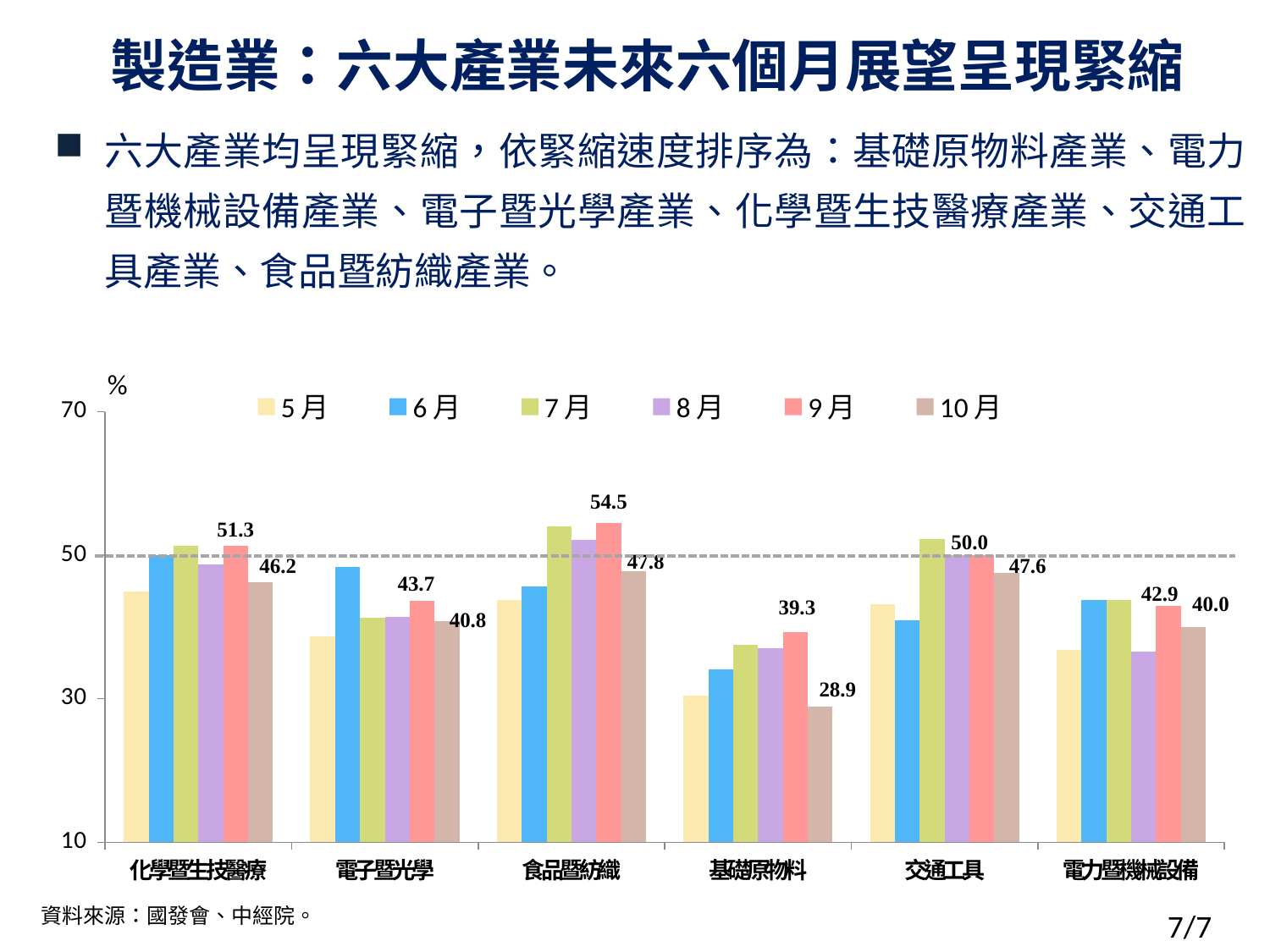
How many industry categories are shown on the x axis? 6 How many series does the legend list? 6 Which category has the lowest 9月 value? 基礎原物料 Is the 7月 value for 食品暨紡織 greater or less than 50? greater What is the value for 10月 in the 基礎原物料 category? 28.9 What kind of chart is shown on the slide? bar chart Which is larger, the 10月 value for 化學暨生技醫療 or the 10月 value for 電子暨光學? 化學暨生技醫療 What is the value for 9月 in the 食品暨紡織 category? 54.5 What is the value for 9月 in the 交通工具 category? 50.0 What is the difference between the 9月 and 10月 values for 基礎原物料? 10.4 Which category has the highest 10月 value? 食品暨紡織 What is the value for 10月 in the 電力暨機械設備 category? 40.0